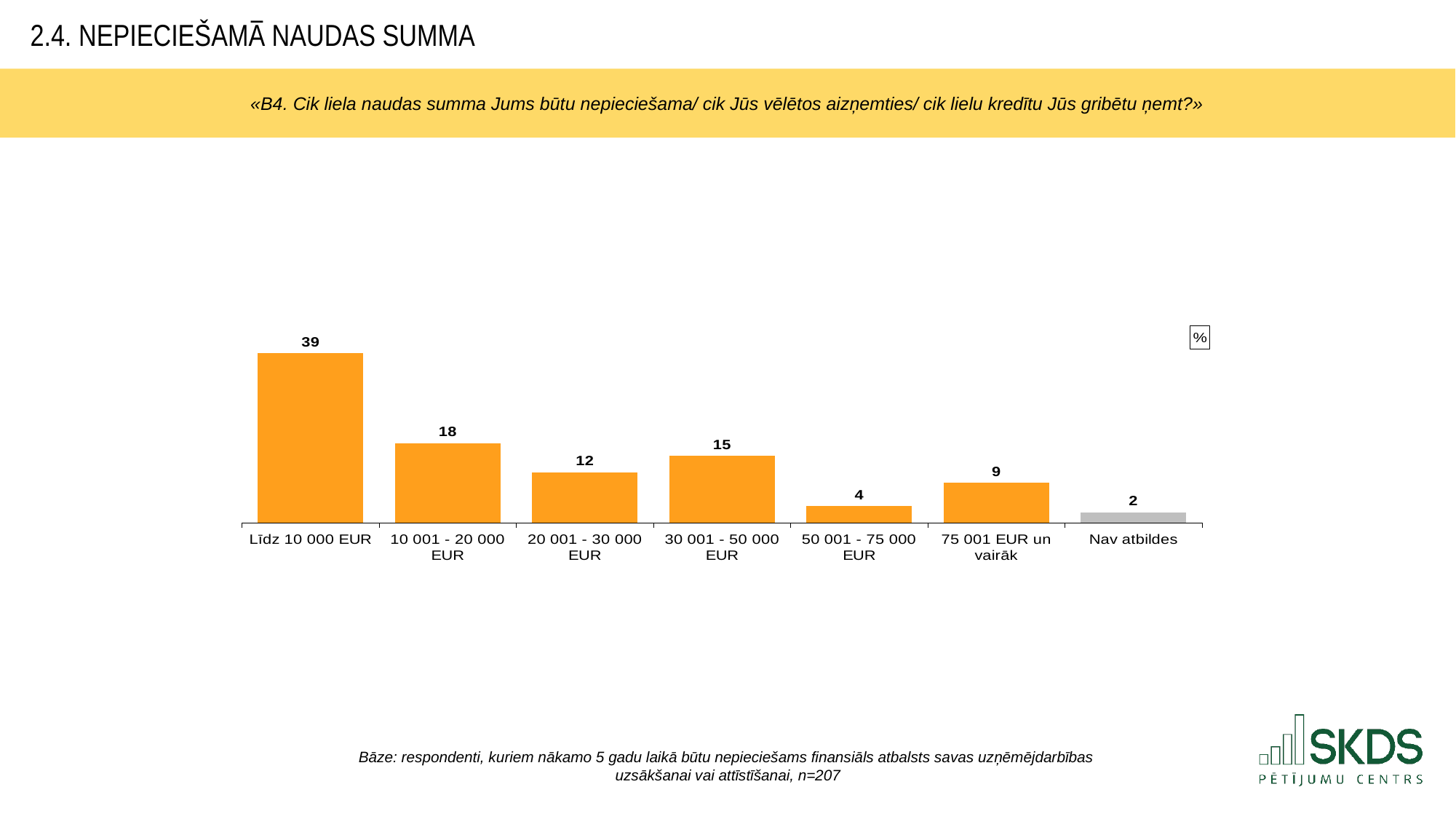
What is the value for "Nav atbildes"? 2 Which category has the highest value? Līdz 10 000 EUR What is the value for "Līdz 10 000 EUR"? 39 What is the value for "30 001 - 50 000 EUR"? 15 What is the difference between the values for "Līdz 10 000 EUR" and "10 001 - 20 000 EUR"? 21 Which category has the lowest value? Nav atbildes Which is larger, the value for "20 001 - 30 000 EUR" or the value for "30 001 - 50 000 EUR"? 30 001 - 50 000 EUR What is the difference between the values for "75 001 EUR un vairāk" and "50 001 - 75 000 EUR"? 5 What unit is indicated in the small box at the top right of the chart? % Which bar is coloured grey rather than orange? Nav atbildes How many categories are shown on the x axis? 7 What kind of chart is shown on the slide? Bar chart